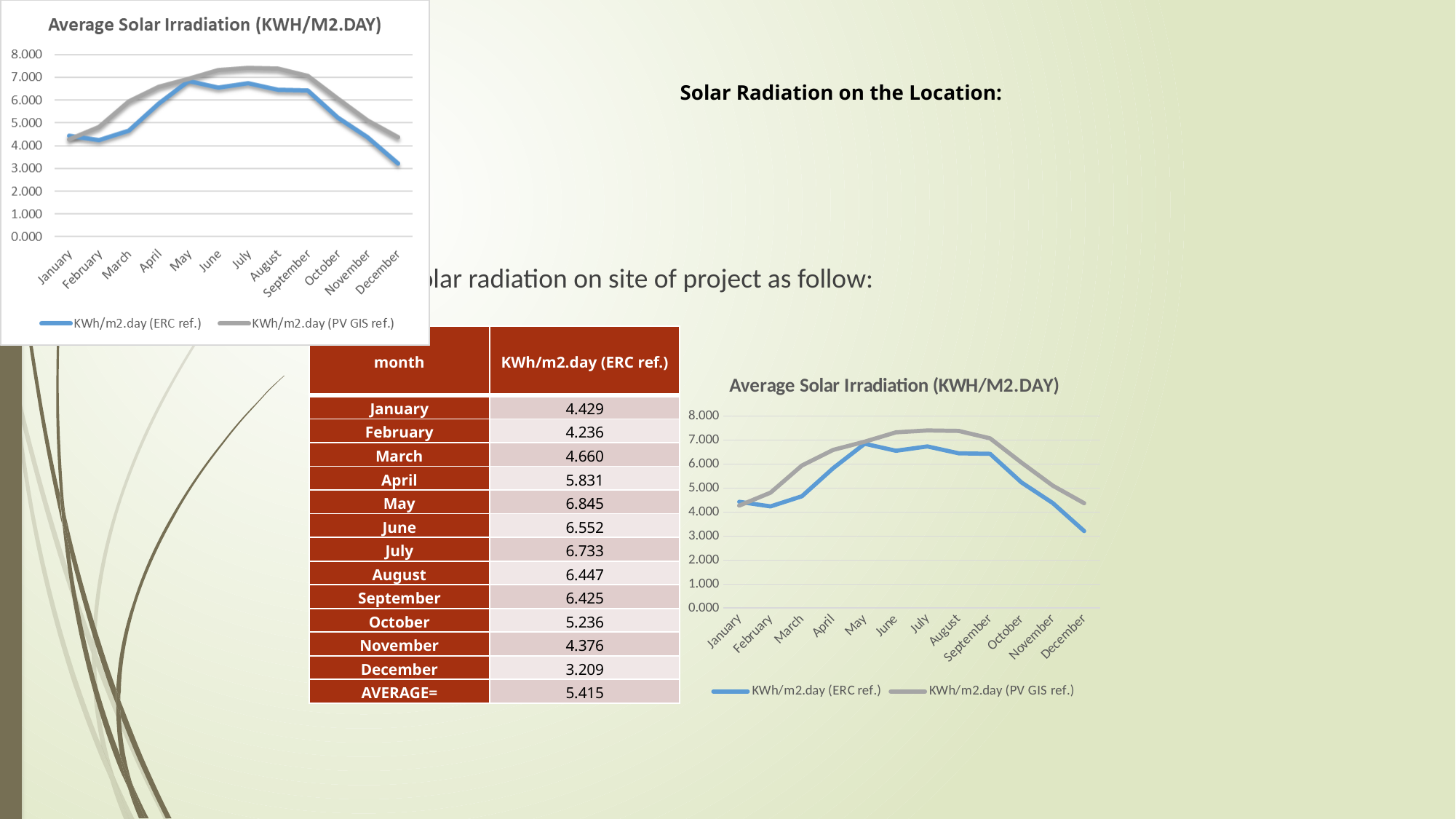
In the top-left chart, is the KWh/m2.day (ERC ref.) value for May greater or less than 6.000? greater In the bottom-right chart, is the KWh/m2.day (PV GIS ref.) value for July greater or less than 7.000? greater What is the title of the bottom-right chart? Average Solar Irradiation (KWH/M2.DAY) In the bottom-right chart, do the KWh/m2.day (ERC ref.) values rise or fall from September to December? fall In the top-left chart, which series is drawn in grey? KWh/m2.day (PV GIS ref.) According to the table on the slide, what is the KWh/m2.day (ERC ref.) value for May? 6.845 How many series does the legend of the top-left chart list? 2 In the bottom-right chart, is the KWh/m2.day (ERC ref.) value for December greater or less than 4.000? less What kind of chart is the chart at the bottom right of the slide? line chart How many months are plotted along the x axis of the bottom-right chart? 12 In the bottom-right chart, which series has the larger value in April, KWh/m2.day (ERC ref.) or KWh/m2.day (PV GIS ref.)? KWh/m2.day (PV GIS ref.) In the bottom-right chart, which month has the lowest KWh/m2.day (ERC ref.) value? December